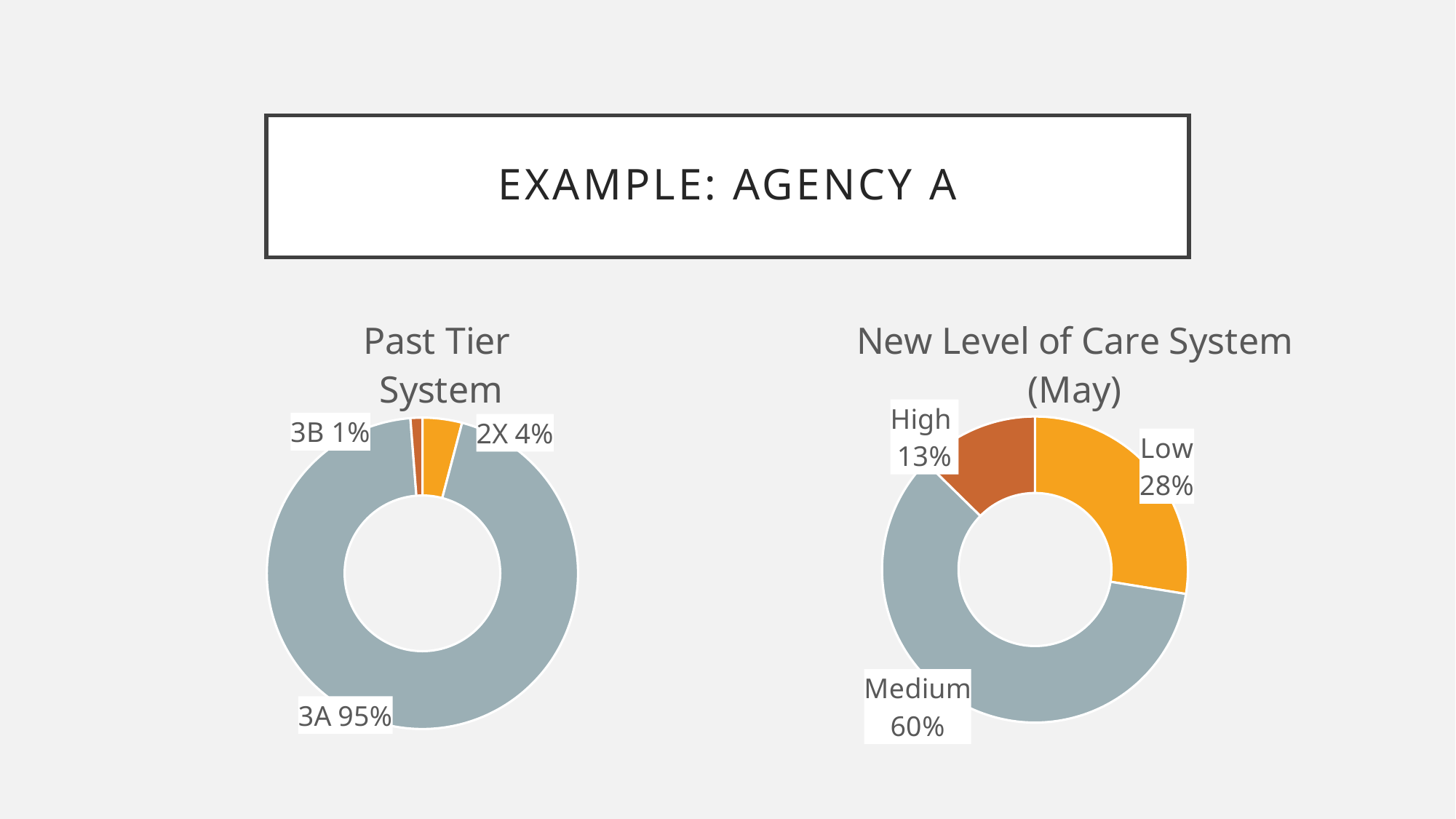
In the 'Past Tier System' chart, what share does 2X have? 4% How many charts are on the slide? 2 In the 'Past Tier System' chart, what share does 3A have? 95% In the 'Past Tier System' chart, how many categories are shown? 3 In the 'Past Tier System' chart, which category has the smallest share? 3B In the 'New Level of Care System (May)' chart, what is the difference between the Low and High shares? 15% In the 'New Level of Care System (May)' chart, which category has the largest share? Medium In the 'New Level of Care System (May)' chart, how many categories are shown? 3 In the 'New Level of Care System (May)' chart, what share does Medium have? 60% In the 'New Level of Care System (May)' chart, what share does High have? 13% In the 'New Level of Care System (May)' chart, which is larger, Low or High? Low What kind of chart is the 'Past Tier System' chart? Doughnut chart